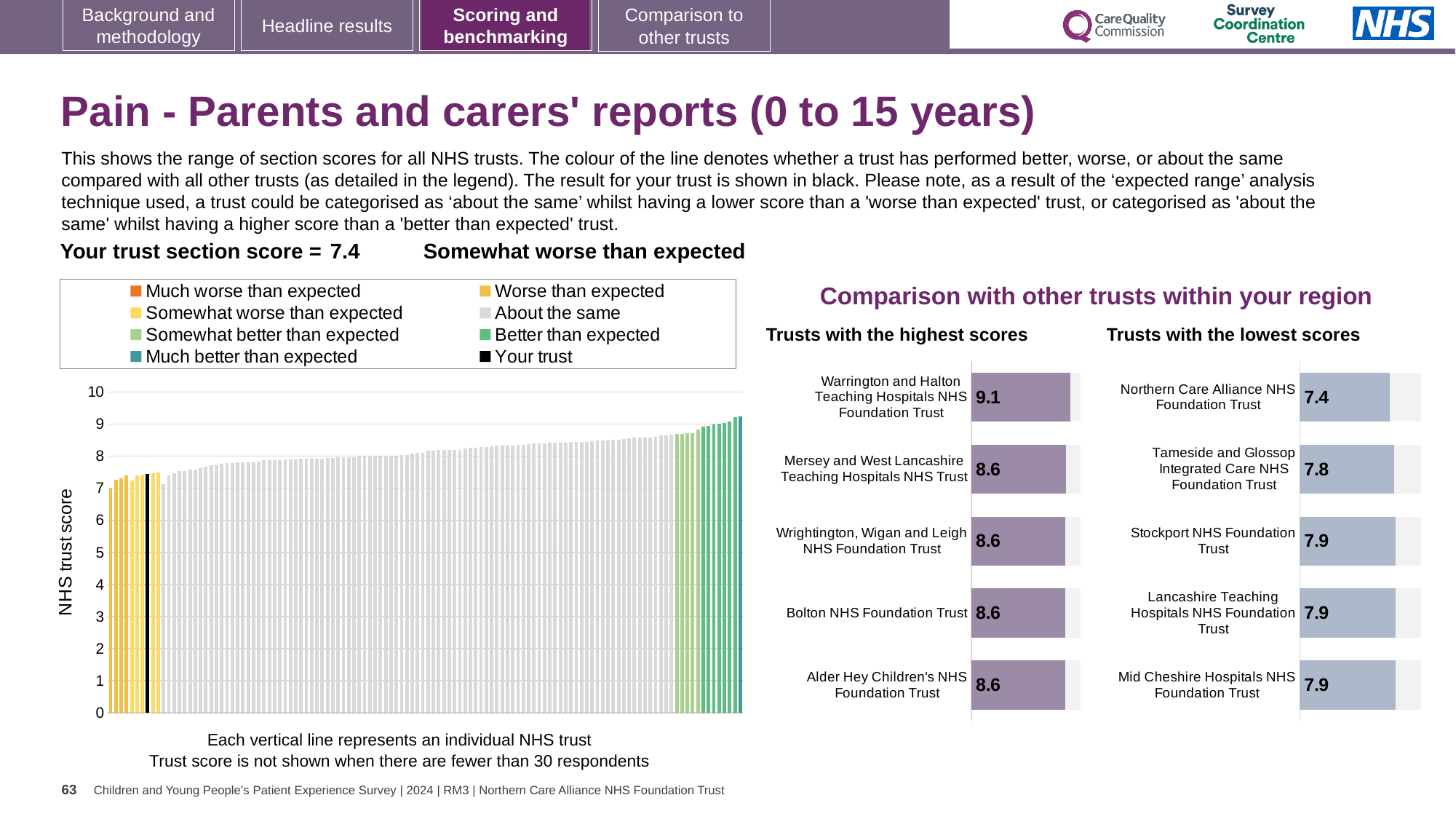
In the 'Trusts with the highest scores' chart, what is the score for Warrington and Halton Teaching Hospitals NHS Foundation Trust? 9.1 In the 'Trusts with the highest scores' chart, what is the difference between the scores of Warrington and Halton Teaching Hospitals NHS Foundation Trust and Bolton NHS Foundation Trust? 0.5 In the large chart on the left showing all NHS trusts, is the value for the black bar (your trust) greater or less than 8? less In the 'Trusts with the lowest scores' chart, what is the difference between the scores of Tameside and Glossop Integrated Care NHS Foundation Trust and Northern Care Alliance NHS Foundation Trust? 0.4 In the 'Trusts with the lowest scores' chart, which trust has the lowest score? Northern Care Alliance NHS Foundation Trust How many entries does the legend of the large chart on the left list? 8 What kind of chart is the large chart on the left showing all NHS trusts? bar chart How many trusts are shown in the 'Trusts with the highest scores' chart? 5 In the 'Trusts with the lowest scores' chart, which has the larger score: Stockport NHS Foundation Trust or Tameside and Glossop Integrated Care NHS Foundation Trust? Stockport NHS Foundation Trust In the 'Trusts with the highest scores' chart, which trust has the highest score? Warrington and Halton Teaching Hospitals NHS Foundation Trust In the 'Trusts with the lowest scores' chart, what is the score for Tameside and Glossop Integrated Care NHS Foundation Trust? 7.8 In the large chart on the left showing all NHS trusts, is the value of the rightmost (highest) bar greater or less than 9? greater